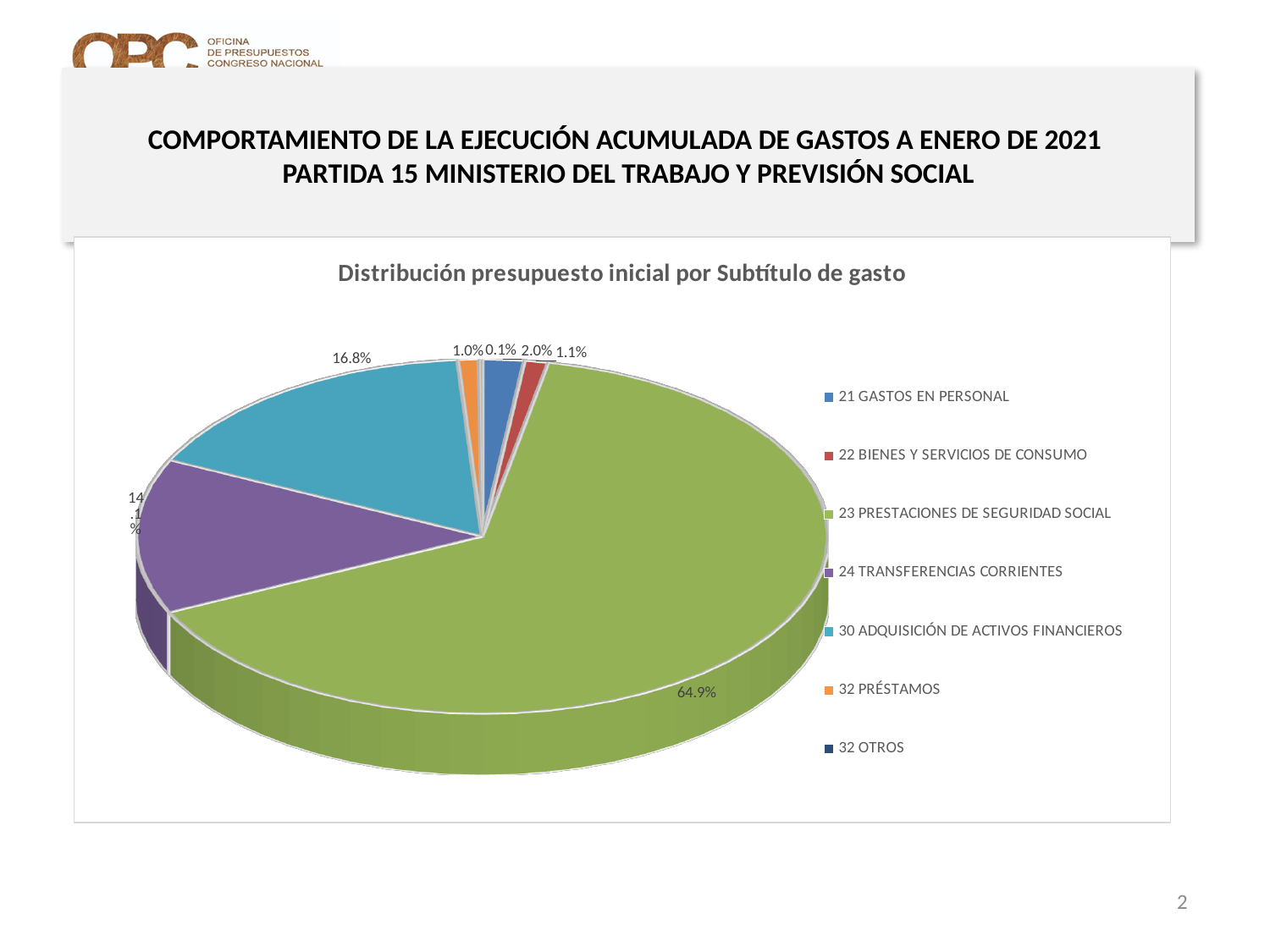
Which category has the smallest slice of the pie? 32 OTROS How many categories does the legend of the pie chart list? 7 Which category has the largest slice of the pie? 23 PRESTACIONES DE SEGURIDAD SOCIAL What is the value shown for 24 TRANSFERENCIAS CORRIENTES? 14.1% What share of the pie does 23 PRESTACIONES DE SEGURIDAD SOCIAL represent? 64.9% What is the title of the chart? Distribución presupuesto inicial por Subtítulo de gasto What type of chart is shown on the slide? Pie chart What is the value shown for 21 GASTOS EN PERSONAL? 2.0% What is the difference in percentage points between 30 ADQUISICIÓN DE ACTIVOS FINANCIEROS and 24 TRANSFERENCIAS CORRIENTES? 2.7 What is the value shown for 32 PRÉSTAMOS? 1.0% Which is larger, the share for 21 GASTOS EN PERSONAL or the share for 22 BIENES Y SERVICIOS DE CONSUMO? 21 GASTOS EN PERSONAL What is the value shown for 30 ADQUISICIÓN DE ACTIVOS FINANCIEROS? 16.8%